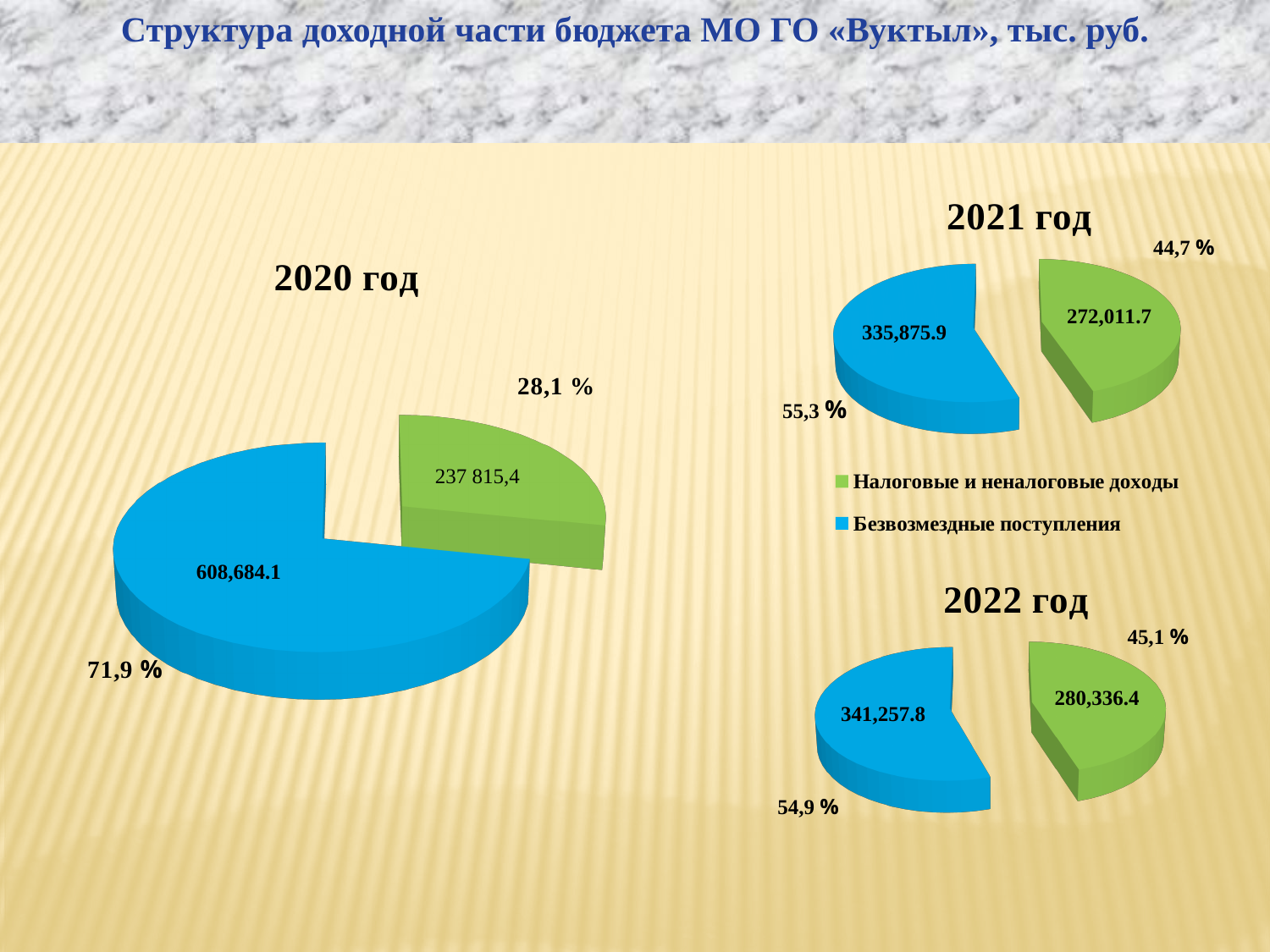
In the 2021 год chart, what is the value for Налоговые и неналоговые доходы? 272,011.7 In the 2021 год chart, which category is the largest? Безвозмездные поступления In the 2022 год chart, which category is the smallest? Налоговые и неналоговые доходы In the 2020 год chart, what is the value for Безвозмездные поступления? 608,684.1 In the 2022 год chart, what share of the pie is Налоговые и неналоговые доходы? 45,1 % What kind of charts are shown on the slide? Pie charts In the 2020 год chart, what is the value for Налоговые и неналоговые доходы? 237 815,4 Which colour represents Налоговые и неналоговые доходы in the charts? Green In the 2021 год chart, what is the difference between Безвозмездные поступления and Налоговые и неналоговые доходы? 63,864.2 How many categories does the legend list? 2 In the 2020 год chart, what share of the pie is Безвозмездные поступления? 71,9 % In the 2022 год chart, what is the value for Безвозмездные поступления? 341,257.8